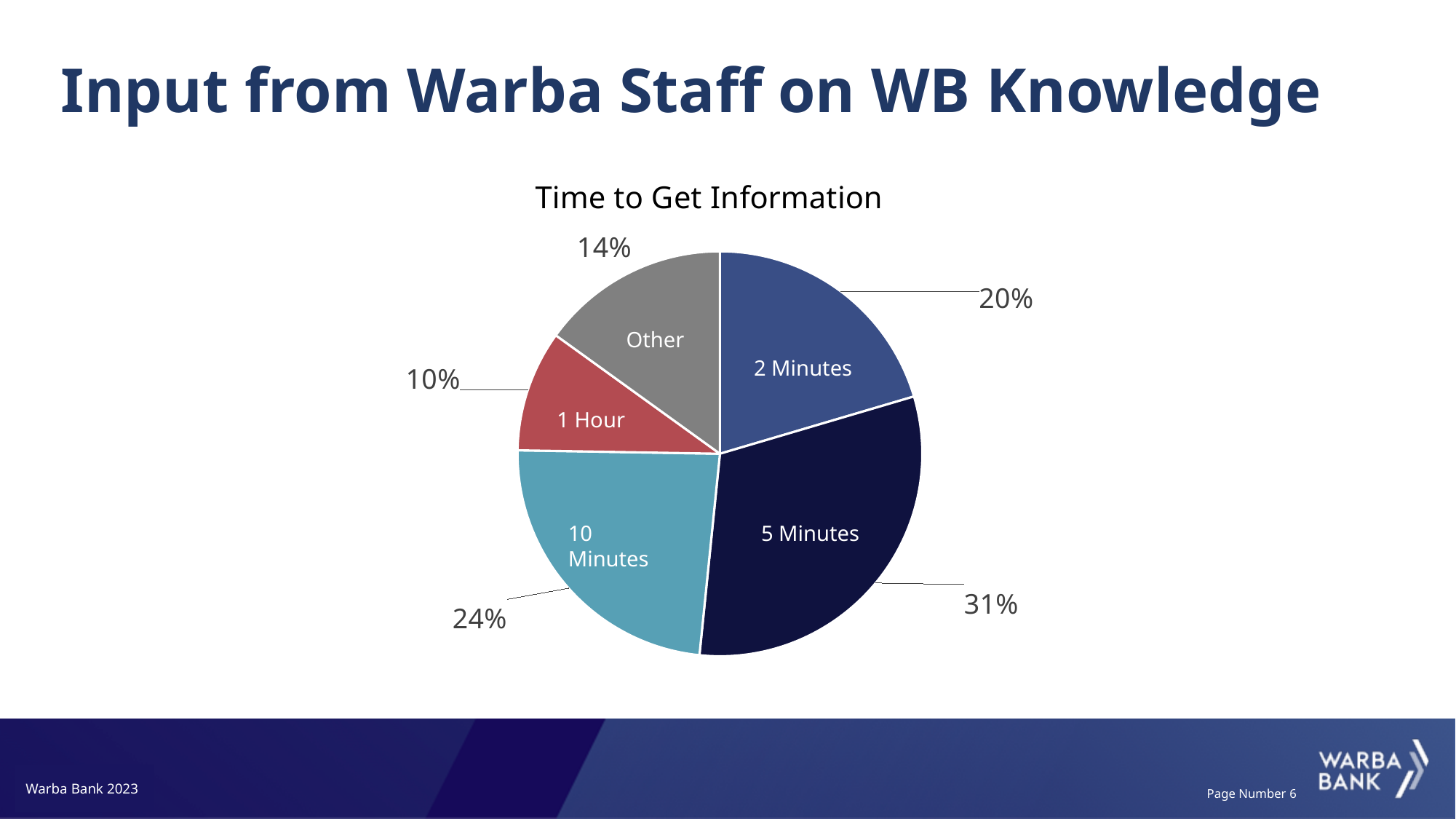
What type of chart is shown on the slide? Pie chart Which category has the largest slice of the pie? 5 Minutes How many slices does the pie chart have? 5 What is the difference in percentage points between the 5 Minutes slice and the 2 Minutes slice? 11 Which slice is larger, 10 Minutes or Other? 10 Minutes Which category has the smallest slice of the pie? 1 Hour What share of the pie does the Other slice represent? 14% What share of the pie does the 5 Minutes slice represent? 31% What share of the pie does the 1 Hour slice represent? 10% What is the title of the chart? Time to Get Information